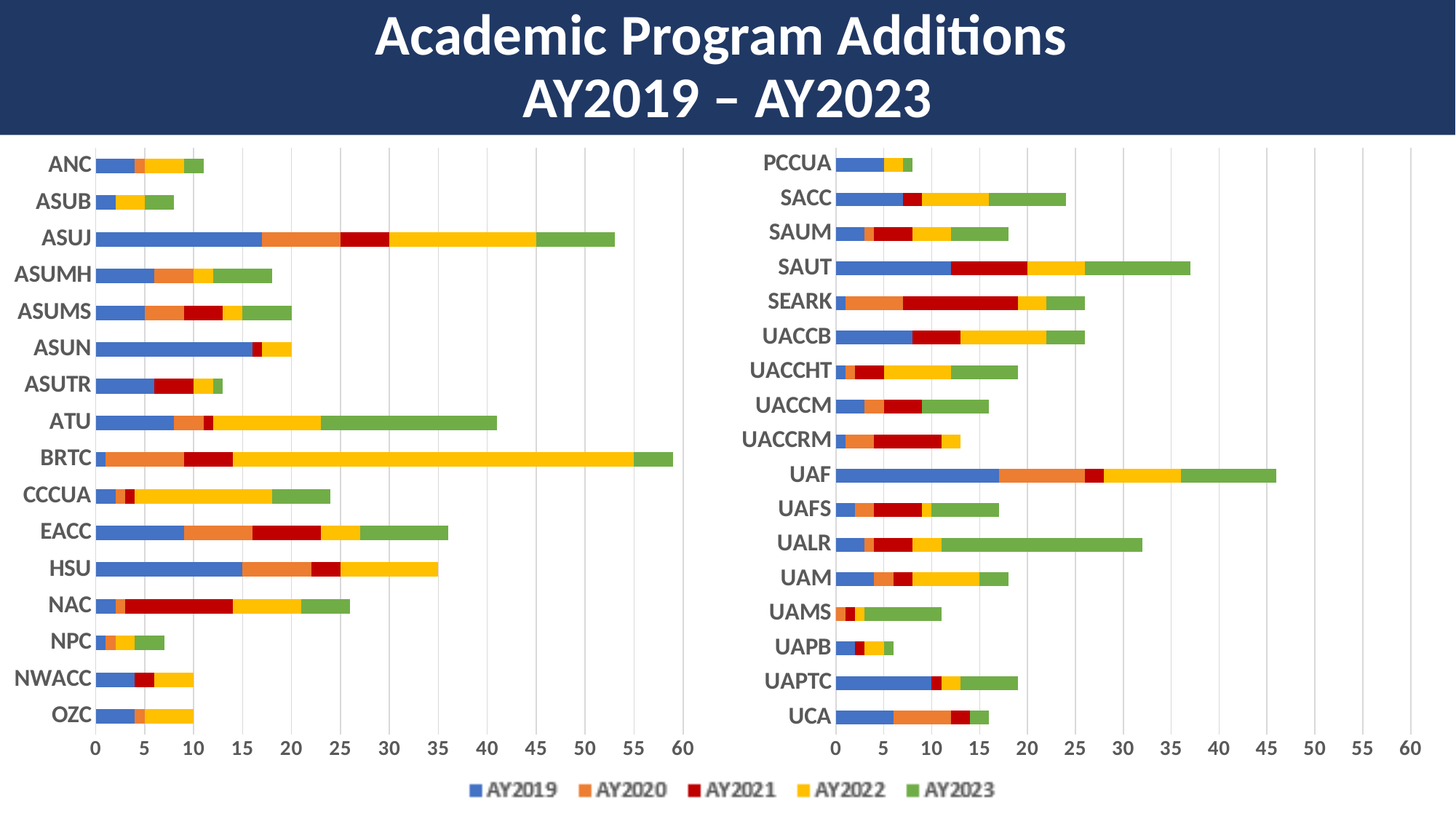
In the right chart, which institution has the longest total bar? UAF In the right chart, which has the longer total bar, UAF or SAUT? UAF In the left chart, which has the longer total bar, ASUJ or ATU? ASUJ What is the title of the slide's charts? Academic Program Additions AY2019 – AY2023 In the right chart, how many institutions are listed on the vertical axis? 17 What kind of chart is shown on the left side of the slide? bar chart How many series does the legend list? 5 In the left chart, how many institutions are listed on the vertical axis? 16 In the right chart, is the total bar for UALR greater or less than 30? greater In the left chart, is the total bar for ASUJ greater or less than 50? greater In the right chart, which institution has the shortest total bar? UAPB In the left chart, which institution has the longest total bar? BRTC